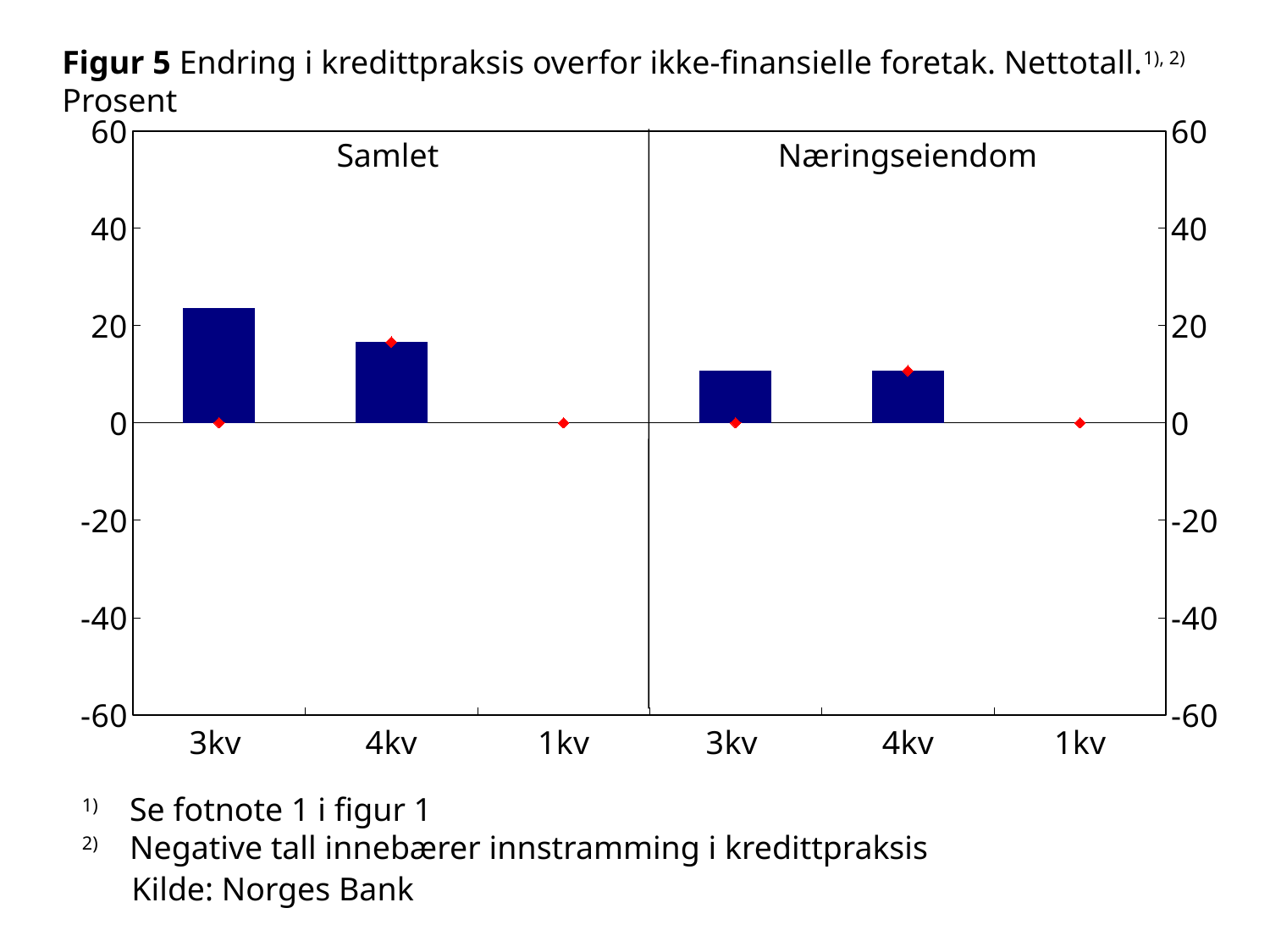
How many quarter categories are shown on the x axis of the Samlet panel? 3 In the Næringseiendom panel, is the bar for 3kv greater or less than 20? less In the Samlet panel, which quarter has the highest bar? 3kv In the Samlet panel, do the bars rise or fall from 3kv to 4kv? fall Which is larger: the Samlet bar for 3kv or the Næringseiendom bar for 3kv? Samlet 3kv In the Samlet panel, is the bar for 4kv greater or less than 20? less What is the maximum value shown on the y axis? 60 In the Samlet panel, which bar is larger: 3kv or 4kv? 3kv In the Næringseiendom panel, is the bar for 4kv greater or less than 0? greater What are the names of the two panels in the chart? Samlet and Næringseiendom What kind of chart is shown on the slide? bar chart